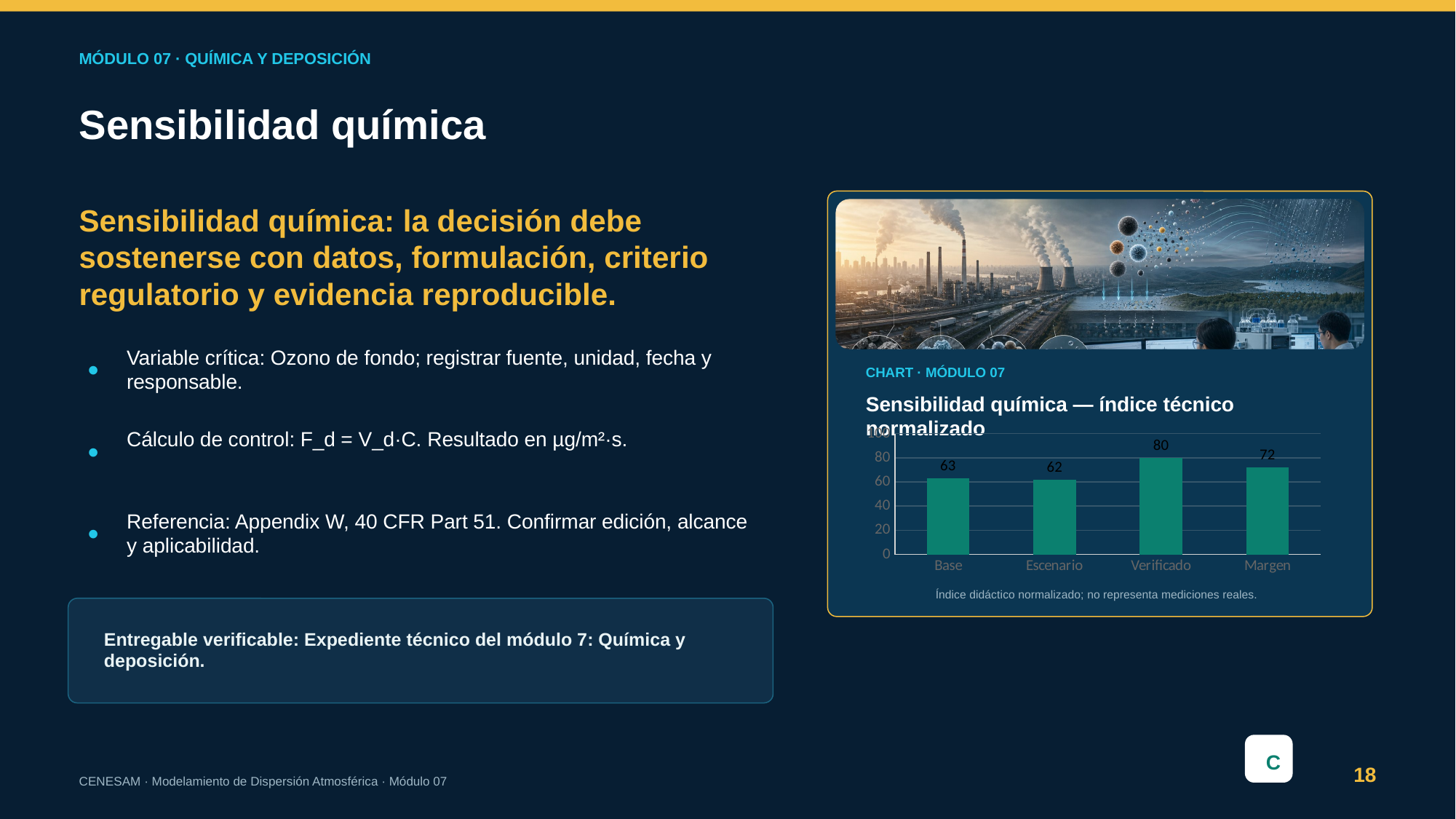
What is the difference between the values for Verificado and Margen? 8 Which category has the highest value? Verificado Which category has the lowest value? Escenario What is the value for Verificado? 80 How many categories are shown on the x axis? 4 What is the value for Base? 63 What kind of chart is shown? bar chart Is the value for Verificado greater or less than 60? greater What is the value for Margen? 72 Which is larger, the value for Margen or the value for Base? Margen What is the title of the chart? Sensibilidad química — índice técnico normalizado What is the value for Escenario? 62